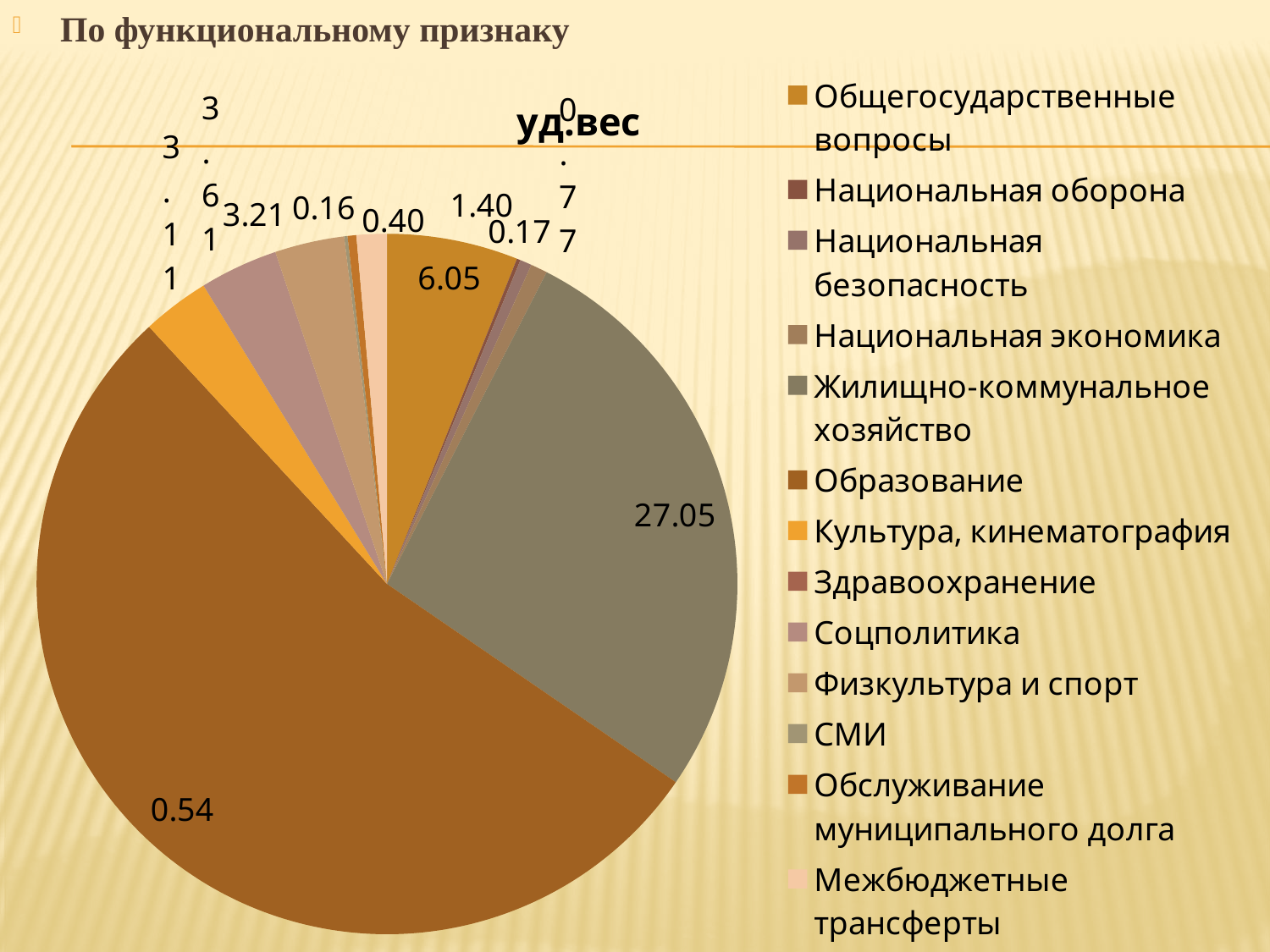
What value is shown for Национальная экономика? 0.77 What value label is printed on the Образование slice? 0.54 What kind of chart is shown on the slide? pie chart What is the title of the chart? уд.вес What is the difference between the values for Жилищно-коммунальное хозяйство and Общегосударственные вопросы? 21.00 Which is larger, the value for Жилищно-коммунальное хозяйство or for Общегосударственные вопросы? Жилищно-коммунальное хозяйство Which category occupies the largest slice of the pie? Образование What value is shown for Межбюджетные трансферты? 1.40 How many categories does the legend of the pie chart list? 13 What value is shown for Культура, кинематография? 3.11 What value is shown for Общегосударственные вопросы? 6.05 What value is shown for Жилищно-коммунальное хозяйство? 27.05